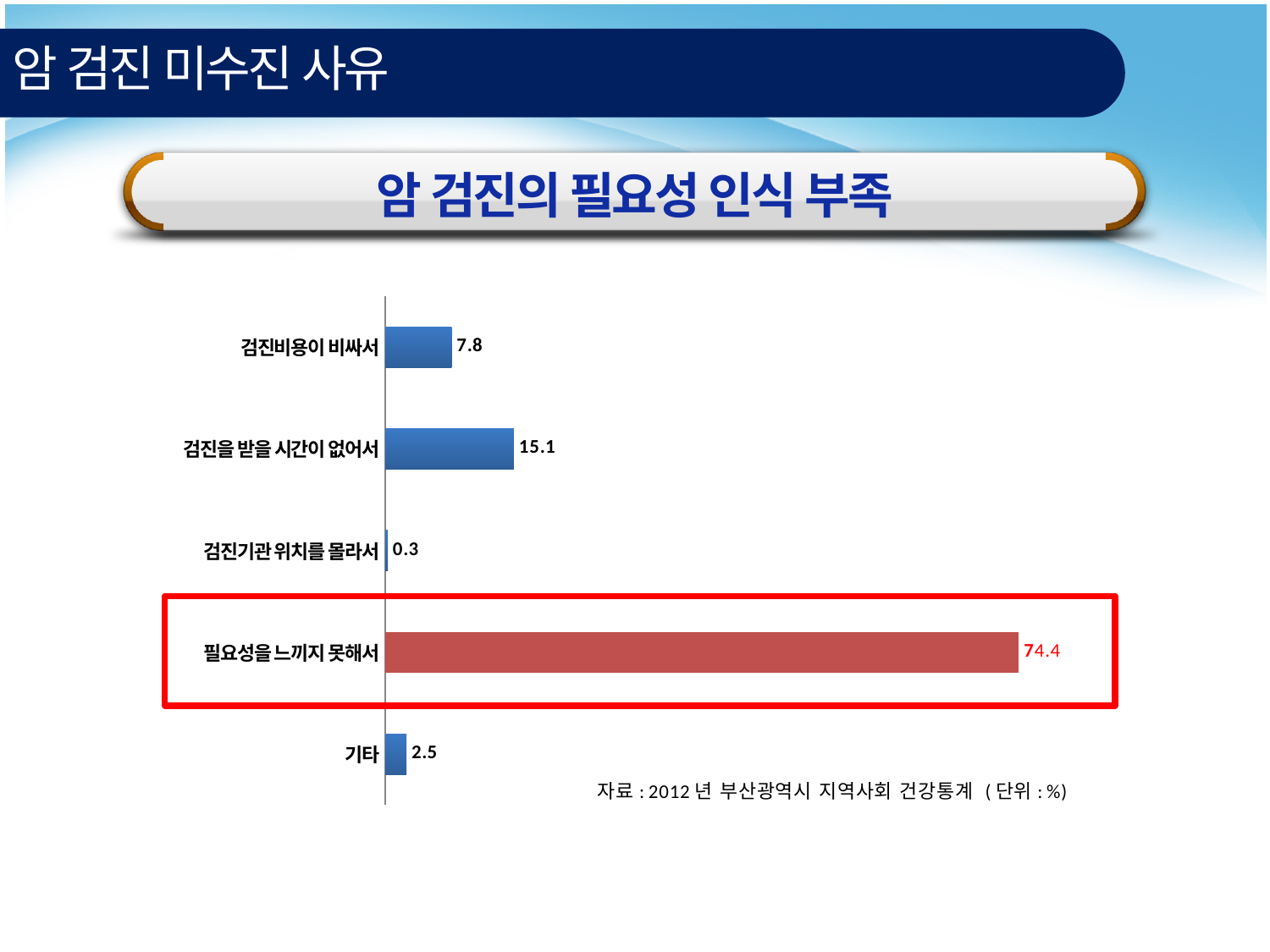
Which category has the highest value? 필요성을 느끼지 못해서 Which bar is shown in a different colour (red) from the others? 필요성을 느끼지 못해서 What is the value for 검진을 받을 시간이 없어서? 15.1 What is the value for 기타? 2.5 What is the value for 검진비용이 비싸서? 7.8 What is the difference between the values for 검진을 받을 시간이 없어서 and 검진비용이 비싸서? 7.3 What kind of chart is shown on the slide? bar chart Which category has the lowest value? 검진기관 위치를 몰라서 Which is larger, the value for 검진비용이 비싸서 or the value for 기타? 검진비용이 비싸서 What is the value for 검진기관 위치를 몰라서? 0.3 What is the value for 필요성을 느끼지 못해서? 74.4 How many categories are shown in the chart? 5